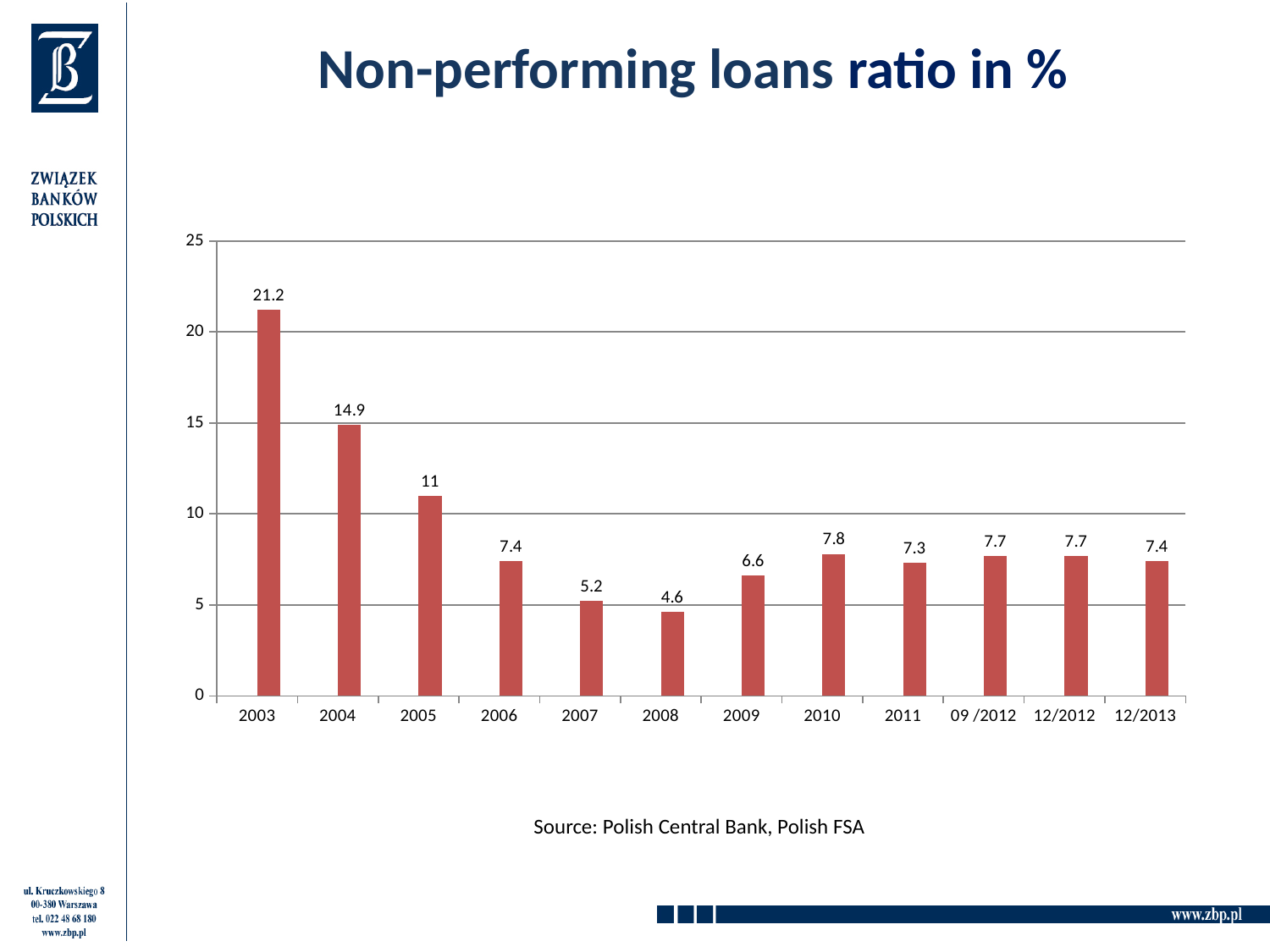
What kind of chart is shown on the slide? bar chart What is the difference between the non-performing loans ratio in 2003 and in 2004? 6.3 Is the value for 2005 greater or less than 10? greater What is the non-performing loans ratio for 2003? 21.2 What is the non-performing loans ratio for 2008? 4.6 What is the difference between the non-performing loans ratio in 2010 and in 2011? 0.5 Which category has the lowest non-performing loans ratio? 2008 What is the non-performing loans ratio for 12/2013? 7.4 Which category has the highest non-performing loans ratio? 2003 How many categories are shown on the x axis? 12 Which is larger, the non-performing loans ratio in 2007 or in 2009? 2009 Do the values rise or fall from 2003 to 2008? fall